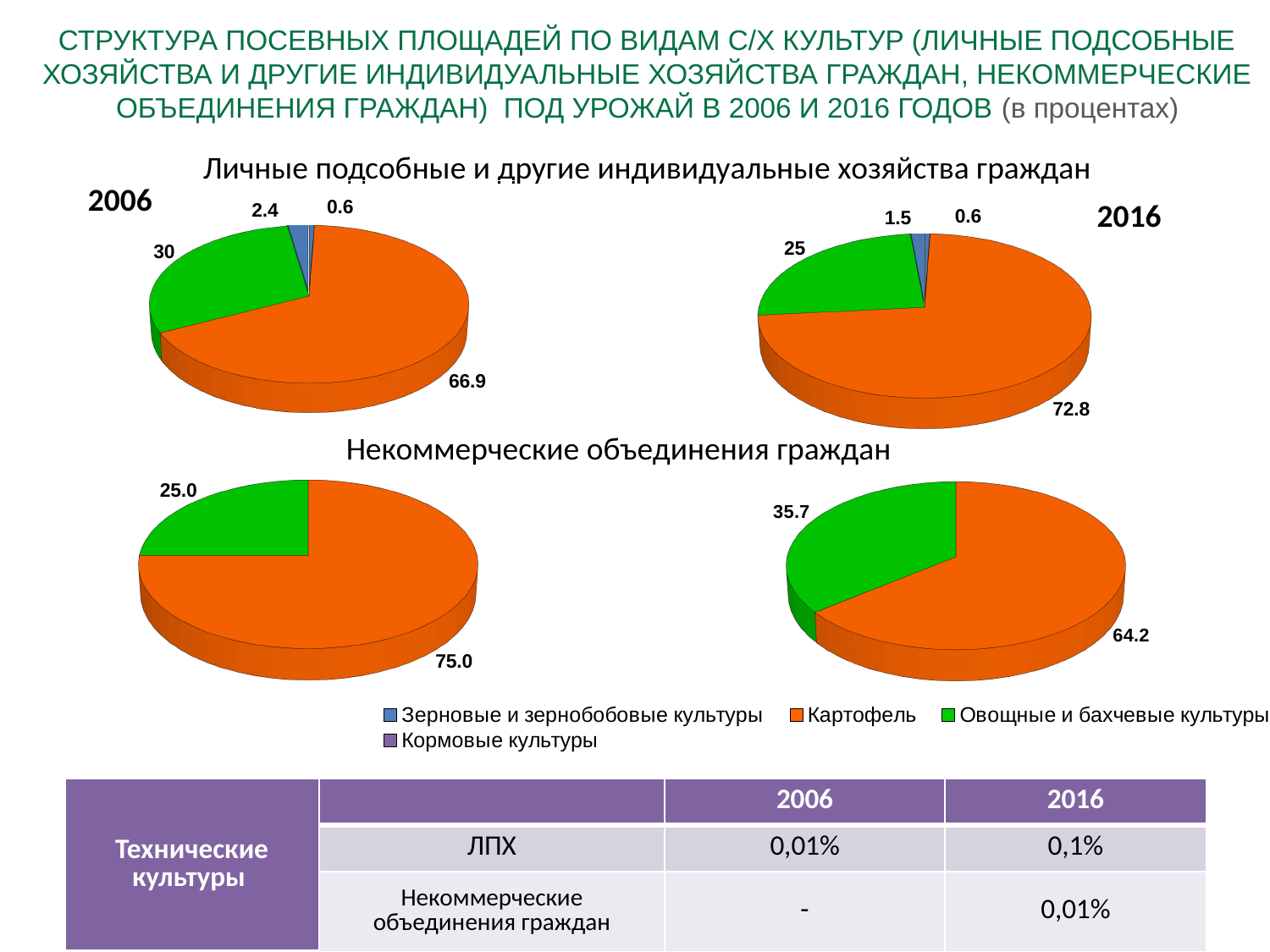
In the 2016 pie chart for 'Некоммерческие объединения граждан', what is the value for Картофель? 64.2 In the 2006 pie chart for 'Личные подсобные и другие индивидуальные хозяйства граждан', which category has the largest share? Картофель In the 2016 pie chart for 'Личные подсобные и другие индивидуальные хозяйства граждан', what is the value for Овощные и бахчевые культуры? 25 In the 2016 pie chart for 'Некоммерческие объединения граждан', which category has the largest share? Картофель In the 2006 pie chart for 'Личные подсобные и другие индивидуальные хозяйства граждан', what is the value for Картофель? 66.9 How many categories does the legend list? 4 What type of chart is used on this slide? Pie chart In the 2006 pie chart for 'Некоммерческие объединения граждан', what is the value for Овощные и бахчевые культуры? 25.0 In the 2016 pie chart for 'Личные подсобные и другие индивидуальные хозяйства граждан', what is the value for Картофель? 72.8 How many slices does the 2006 pie chart for 'Некоммерческие объединения граждан' have? 2 Is the Овощные и бахчевые культуры share larger in the 2006 or the 2016 pie chart for 'Некоммерческие объединения граждан'? 2016 In the 2016 pie chart for 'Некоммерческие объединения граждан', what is the difference between the Картофель and Овощные и бахчевые культуры values? 28.5